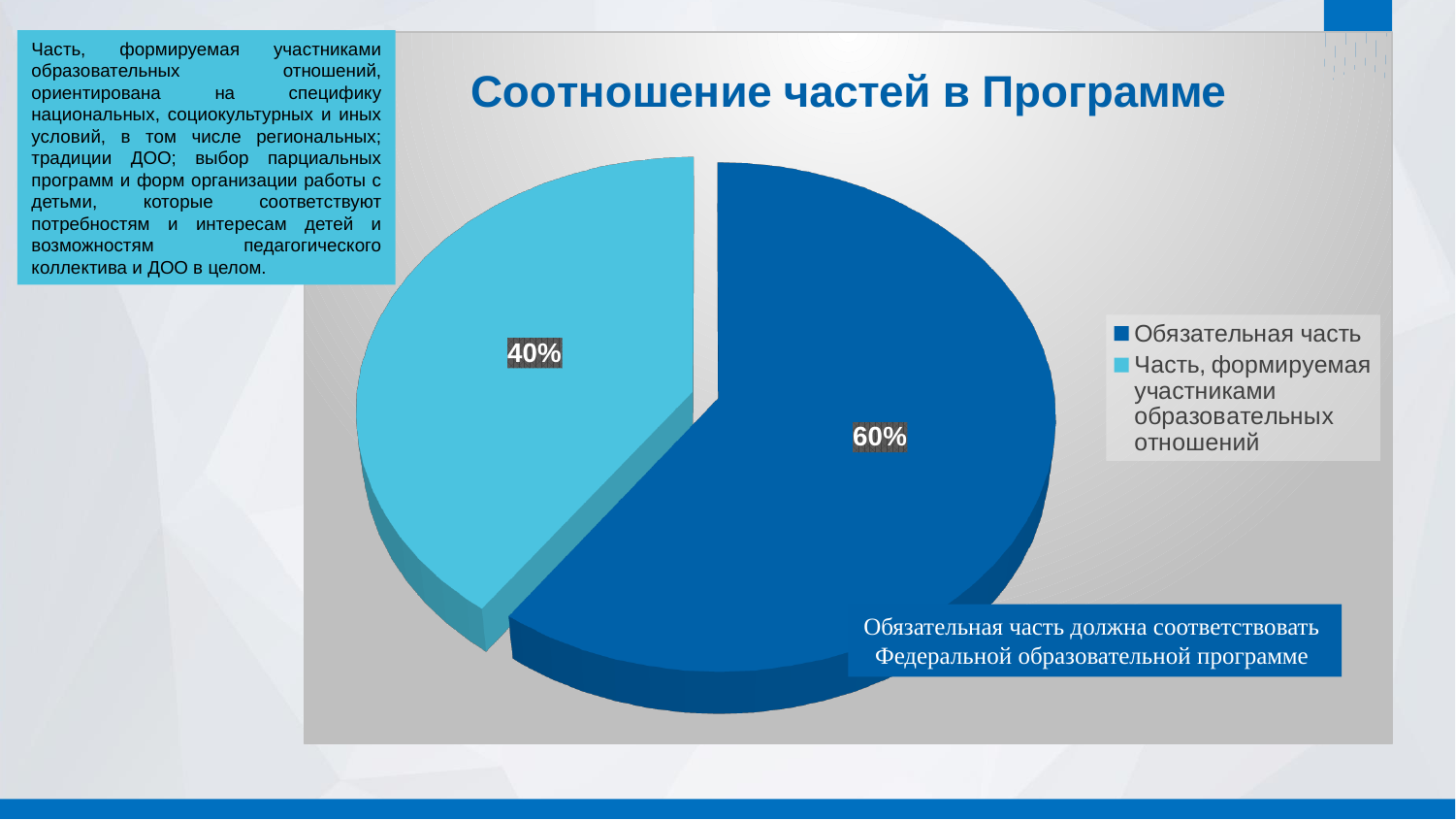
What colour is the "Обязательная часть" slice in the pie chart? dark blue What is the difference in percentage points between the "Обязательная часть" slice and the "Часть, формируемая участниками образовательных отношений" slice? 20% How many entries does the legend list? 2 What is the title of the chart? Соотношение частей в Программе What share of the pie does "Обязательная часть" take? 60% Which is larger: the "Обязательная часть" slice or the "Часть, формируемая участниками образовательных отношений" slice? Обязательная часть How many slices does the pie chart have? 2 Is the share for "Обязательная часть" greater or less than 50%? greater Which slice of the pie is the largest? Обязательная часть What share of the pie does "Часть, формируемая участниками образовательных отношений" take? 40% What kind of chart is shown on the slide? pie chart Which slice of the pie is the smallest? Часть, формируемая участниками образовательных отношений